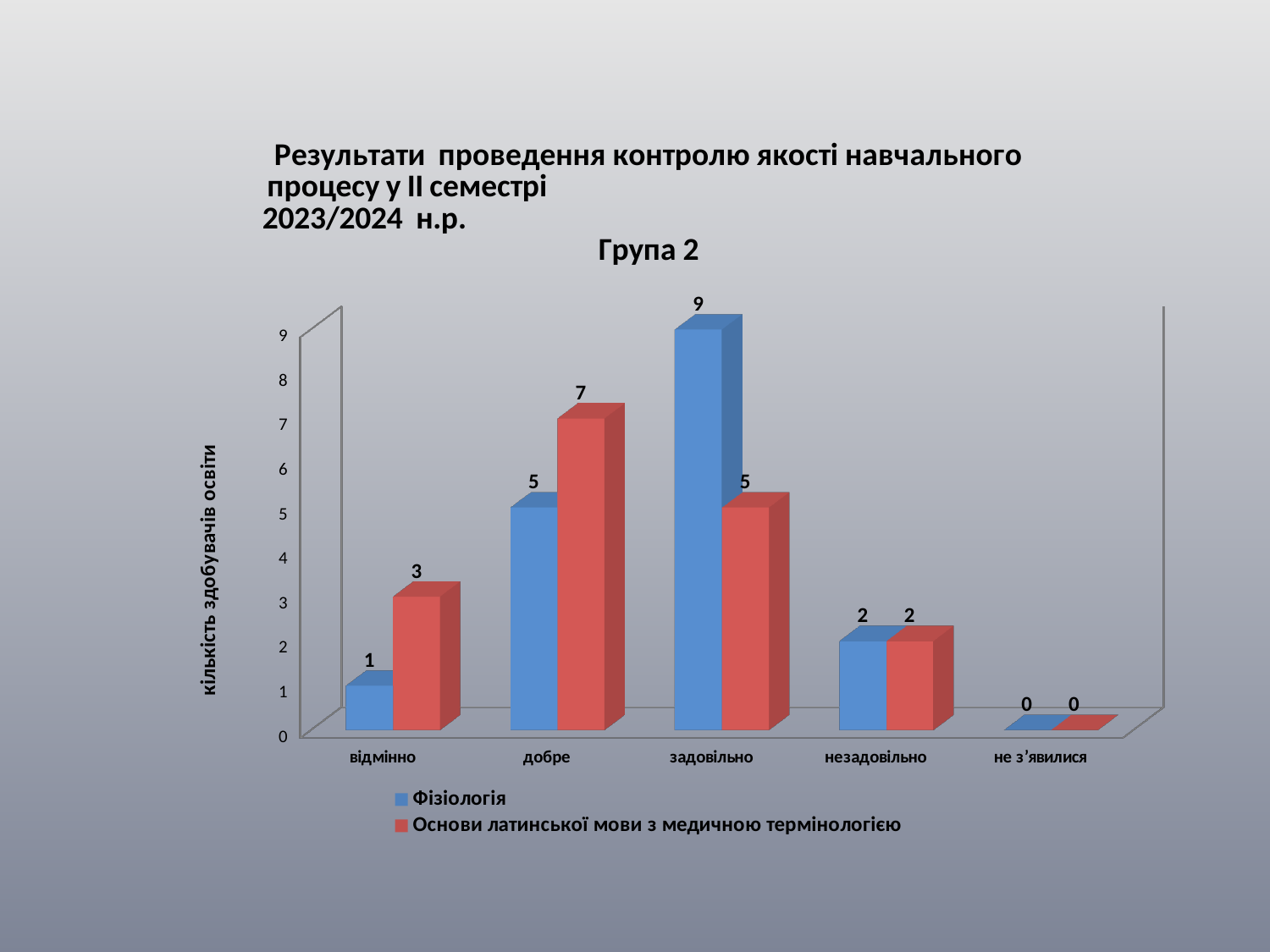
What is the value for Фізіологія in the відмінно category? 1 What is the value for Основи латинської мови з медичною термінологією in the добре category? 7 In the відмінно category, which series has the larger value? Основи латинської мови з медичною термінологією What is the title of the chart? Результати проведення контролю якості навчального процесу у ІІ семестрі 2023/2024 н.р. Група 2 What is the difference between the Фізіологія and Основи латинської мови з медичною термінологією values in the задовільно category? 4 What kind of chart is shown on the slide? bar chart What is the value for Фізіологія in the задовільно category? 9 What is the label of the vertical axis? кількість здобувачів освіти Which category has the lowest value for Основи латинської мови з медичною термінологією? не з’явилися How many series does the legend list? 2 Which category has the highest value for Фізіологія? задовільно How many categories are shown on the x axis? 5